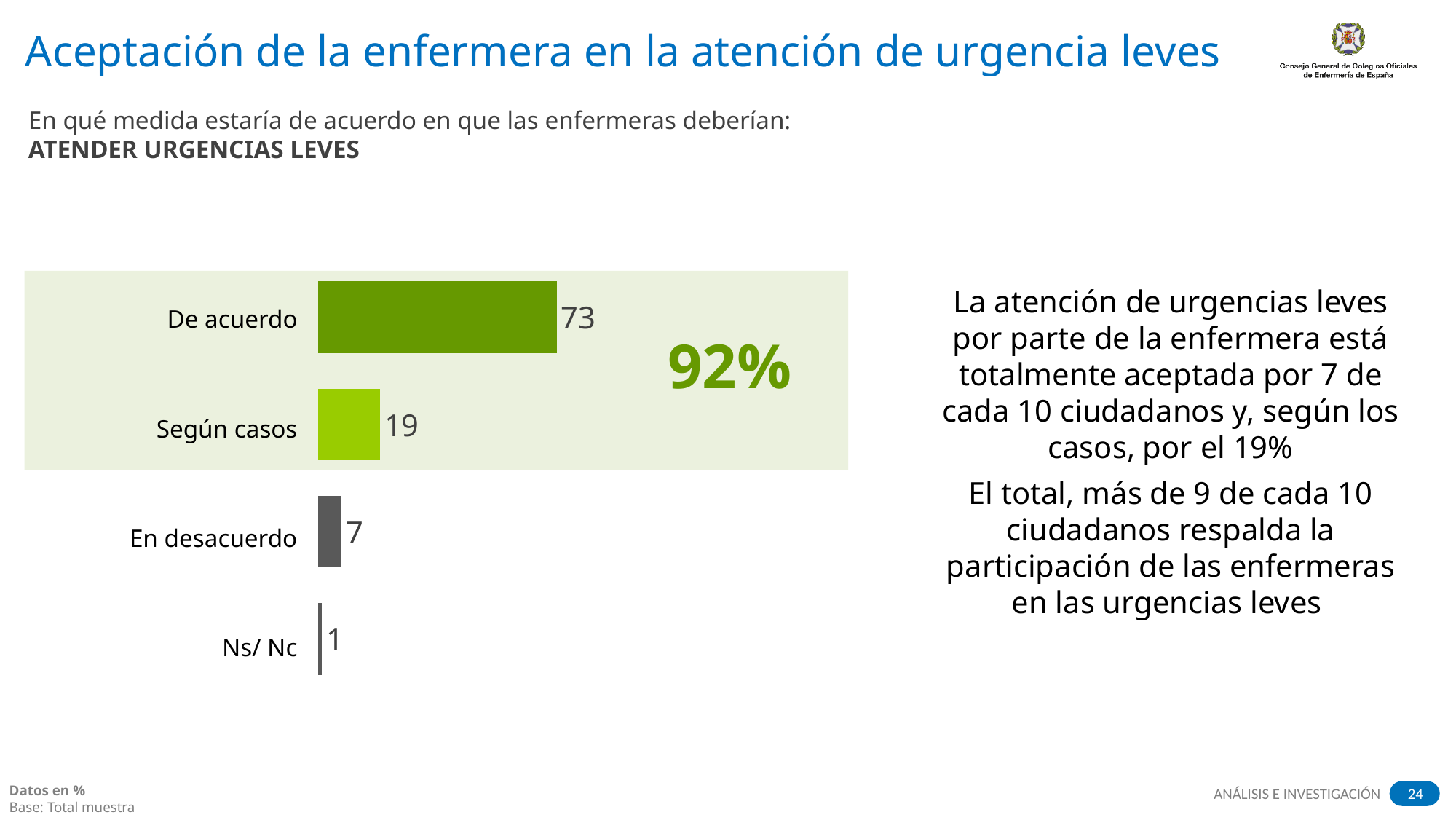
What is the value for "En desacuerdo"? 7 What is the value for "Ns/ Nc"? 1 Which category has the highest value? De acuerdo What is the difference between the values for "De acuerdo" and "Según casos"? 54 What is the difference between the values for "Según casos" and "En desacuerdo"? 12 What kind of chart is shown on the slide? Bar chart What combined percentage is highlighted in the shaded area covering "De acuerdo" and "Según casos"? 92% What is the value for "Según casos"? 19 Which category has the lowest value? Ns/ Nc What is the value for "De acuerdo"? 73 How many categories are shown in the chart? 4 Which is larger, the value for "En desacuerdo" or the value for "Según casos"? Según casos